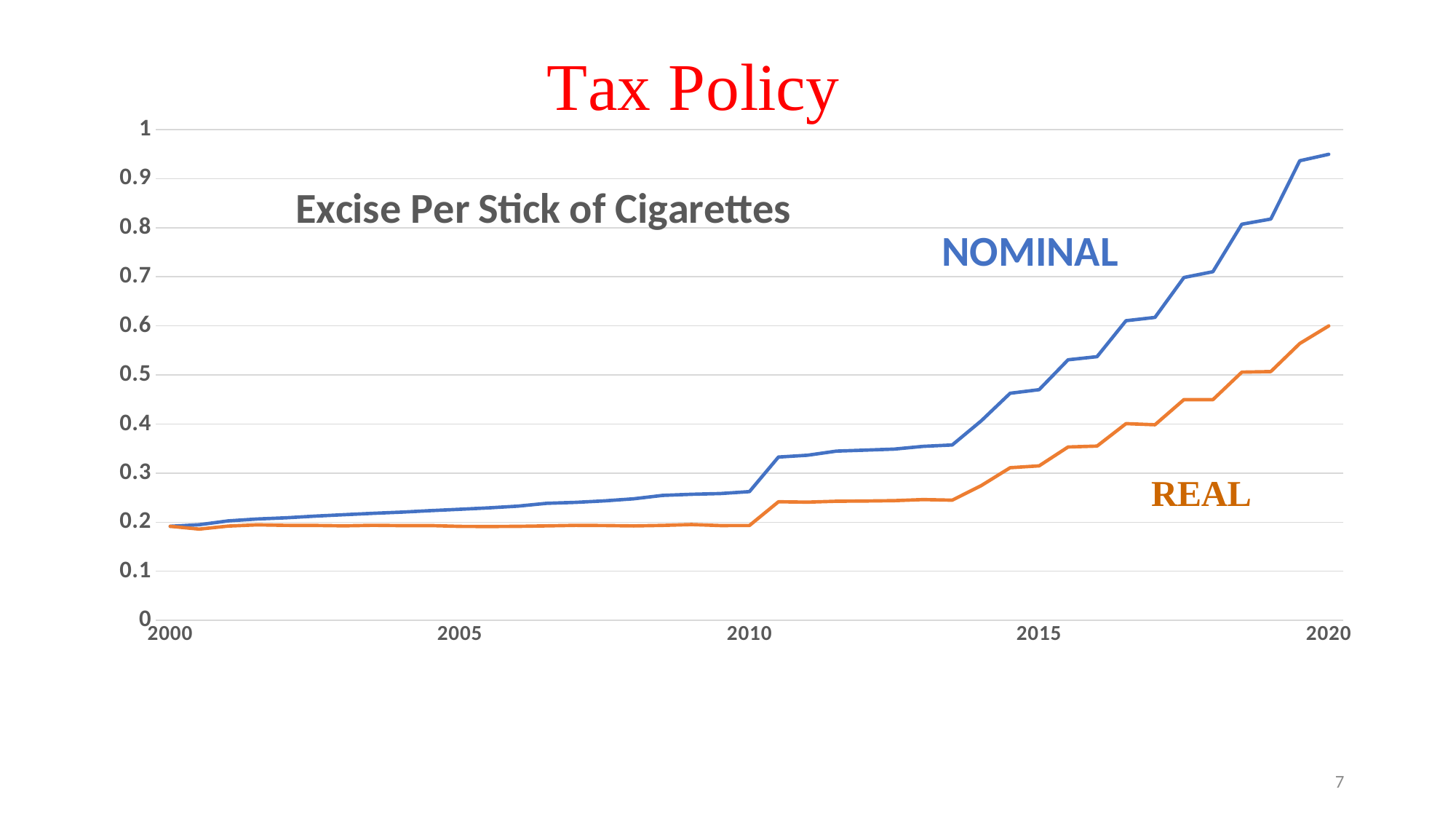
Is the NOMINAL value in 2010 greater or less than 0.3? less Do the NOMINAL values rise or fall from 2000 to 2020? rise What colour is the NOMINAL line? blue Is the NOMINAL value in 2020 greater or less than 0.9? greater Which series is higher in 2020, NOMINAL or REAL? NOMINAL Is the NOMINAL value in 2015 greater or less than 0.5? less What is the title of the chart? Excise Per Stick of Cigarettes What kind of chart is shown on the slide? line chart How many series are plotted on the chart? 2 Do the REAL values rise or fall from 2010 to 2020? rise